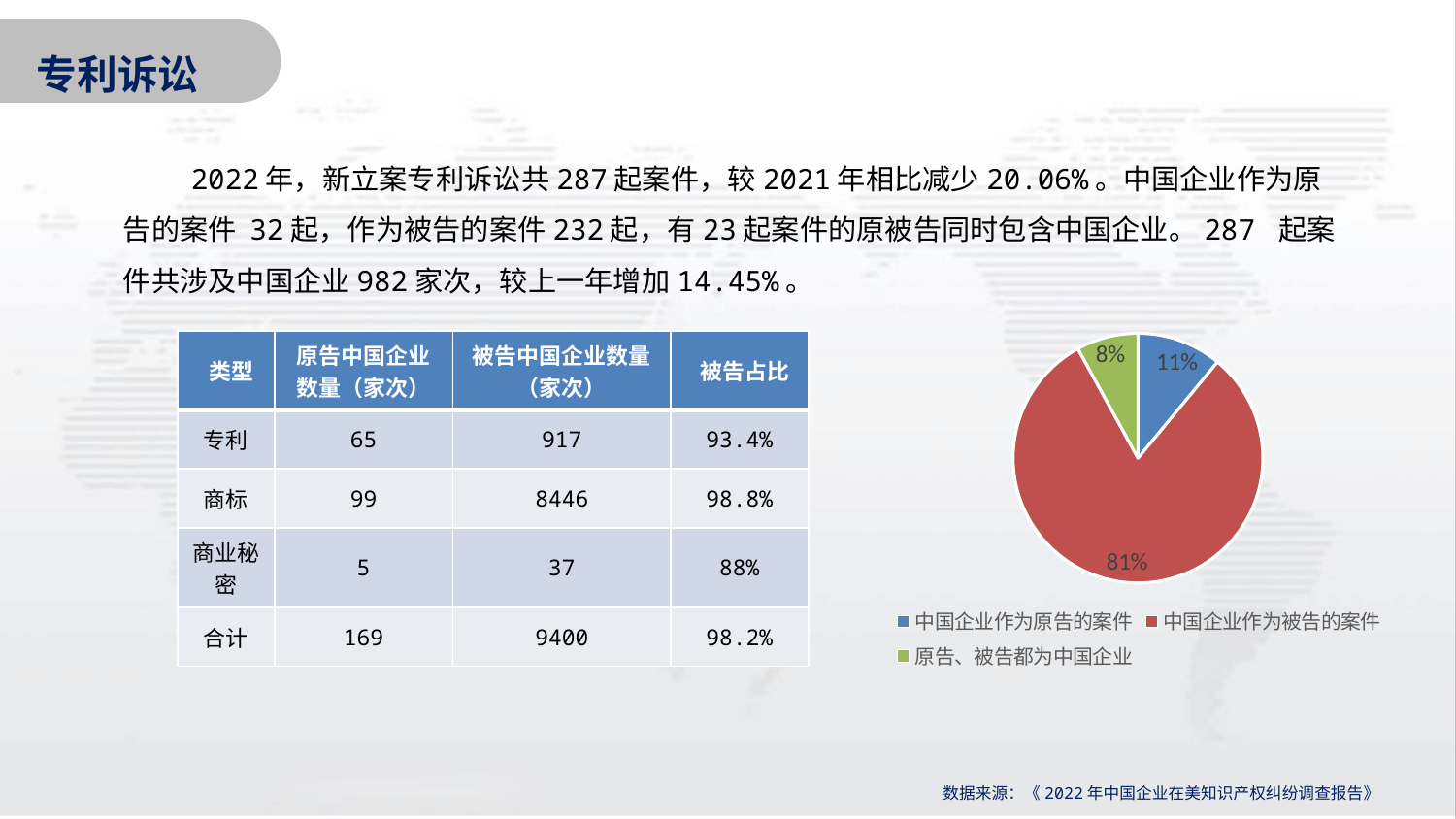
How many entries does the pie chart's legend list? 3 What share of the pie chart is labelled 原告、被告都为中国企业? 8% What kind of chart is shown on the slide? Pie chart Which slice is larger in the pie chart: 中国企业作为原告的案件 or 原告、被告都为中国企业? 中国企业作为原告的案件 What share of the pie chart is labelled 中国企业作为原告的案件? 11% What is the difference in percentage points between the 中国企业作为被告的案件 slice and the 中国企业作为原告的案件 slice? 70 percentage points How many slices does the pie chart have? 3 What colour is the 原告、被告都为中国企业 slice in the pie chart? Green Which category has the smallest slice in the pie chart? 原告、被告都为中国企业 Which category has the largest slice in the pie chart? 中国企业作为被告的案件 What colour is the 中国企业作为被告的案件 slice in the pie chart? Red What share of the pie chart is labelled 中国企业作为被告的案件? 81%